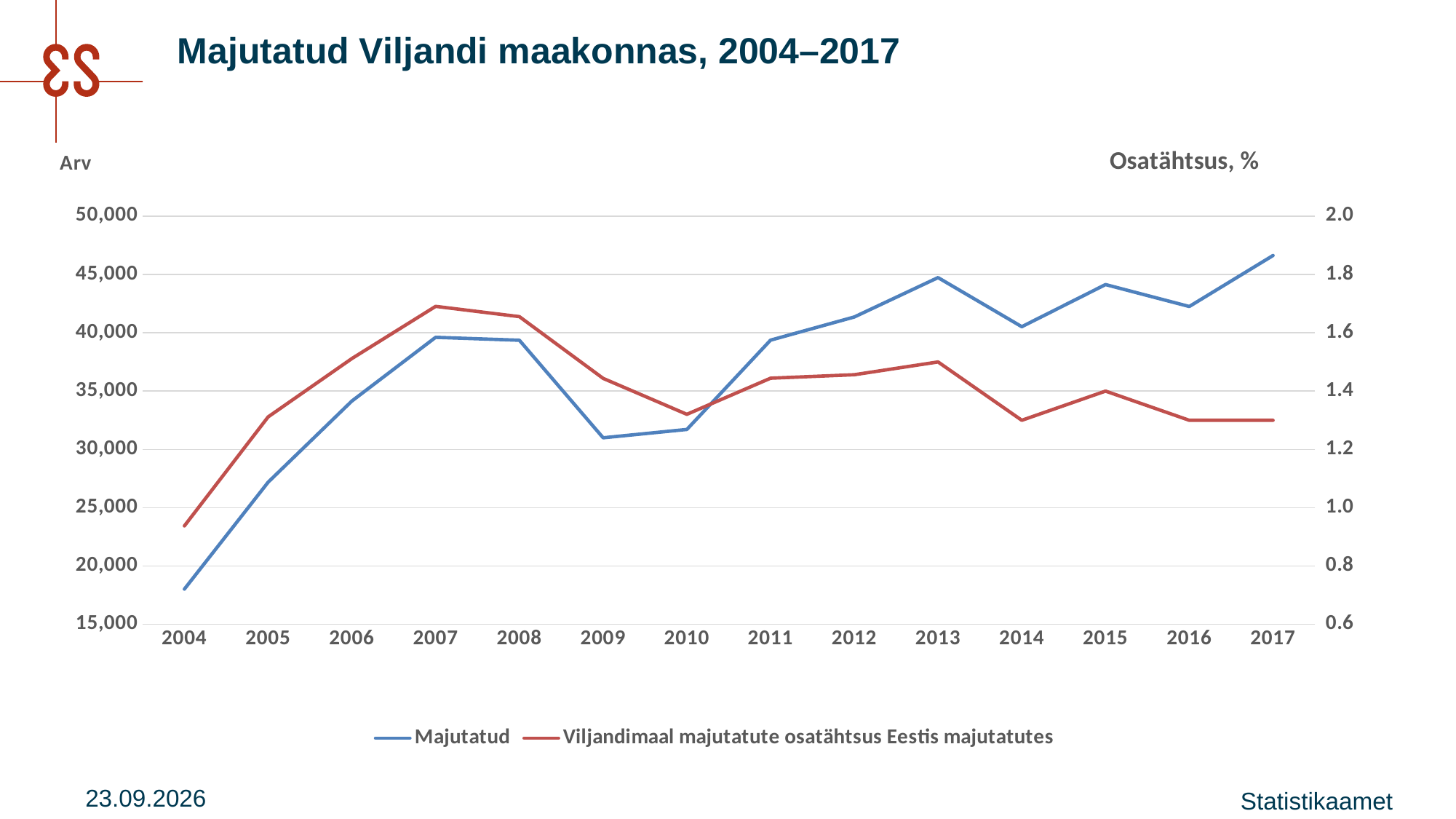
Is the Majutatud value for 2004 greater or less than 20,000? less In which year is the Majutatud series at its highest? 2017 Is the value of 'Viljandimaal majutatute osatähtsus Eestis majutatutes' for 2007 greater or less than 1.6? greater Which year has the larger Majutatud value, 2009 or 2011? 2011 In which year is the Majutatud series at its lowest? 2004 In which year is the series 'Viljandimaal majutatute osatähtsus Eestis majutatutes' at its lowest? 2004 What is the title of the right-hand vertical axis? Osatähtsus, % Is the Majutatud value for 2013 greater or less than 40,000? greater How many years are plotted along the x axis? 14 How many series does the legend list? 2 In which year does the series 'Viljandimaal majutatute osatähtsus Eestis majutatutes' reach its highest value? 2007 What kind of chart is shown on the slide? line chart